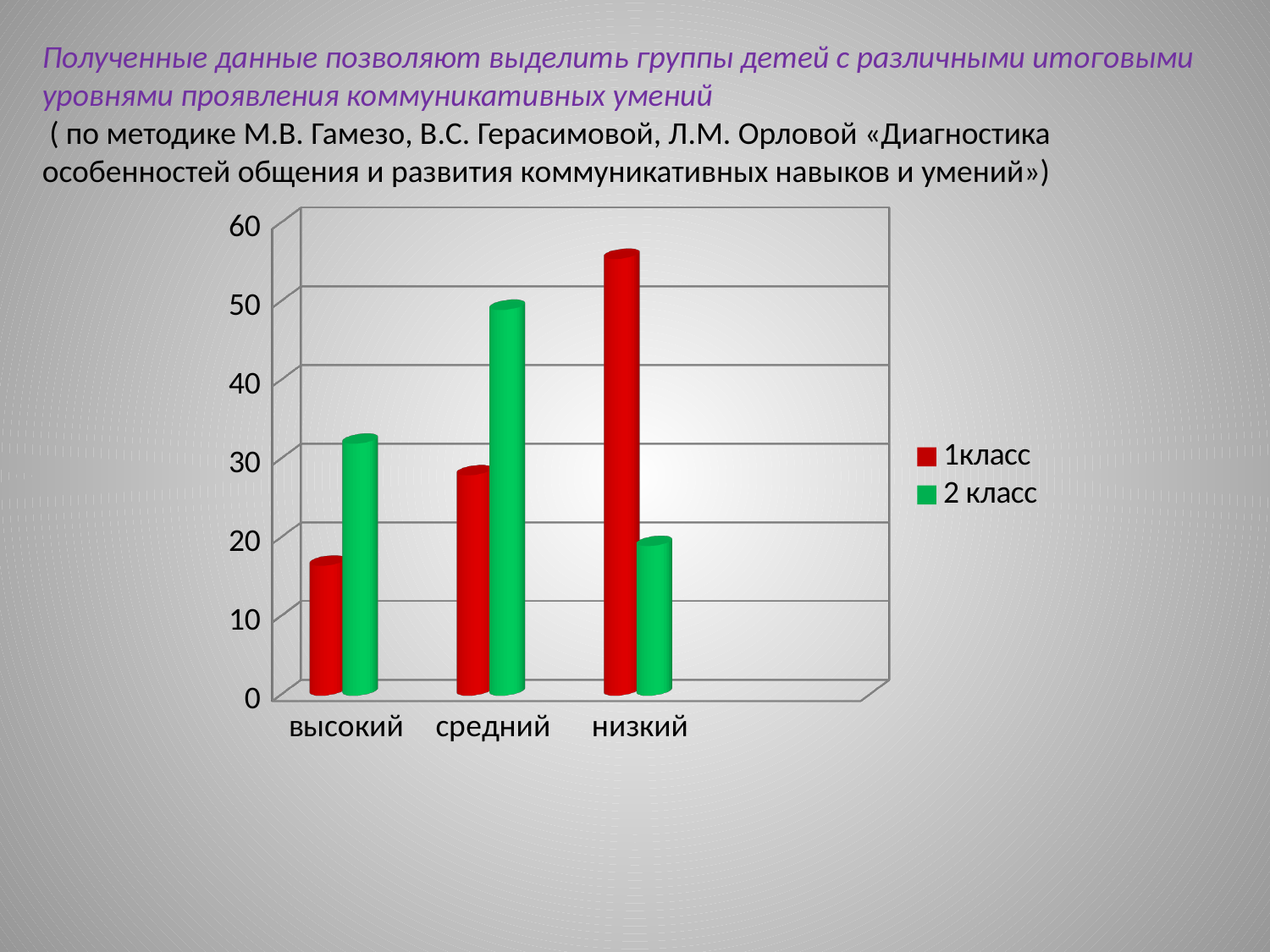
For which category is the 2 класс bar the lowest? низкий For which category is the 1класс bar the highest? низкий How many series does the chart legend list? 2 Is the value for 1класс in the низкий category greater or less than 50? greater Do the 1класс values rise or fall moving from высокий to низкий along the x axis? rise In the высокий category, which series has the larger value, 1класс or 2 класс? 2 класс How many categories are shown on the x axis of the chart? 3 Which series is shown in red in the chart? 1класс For which category is the 2 класс bar the highest? средний In the низкий category, which series has the larger value, 1класс or 2 класс? 1класс What type of chart is shown on the slide? bar chart For which category is the 1класс bar the lowest? высокий